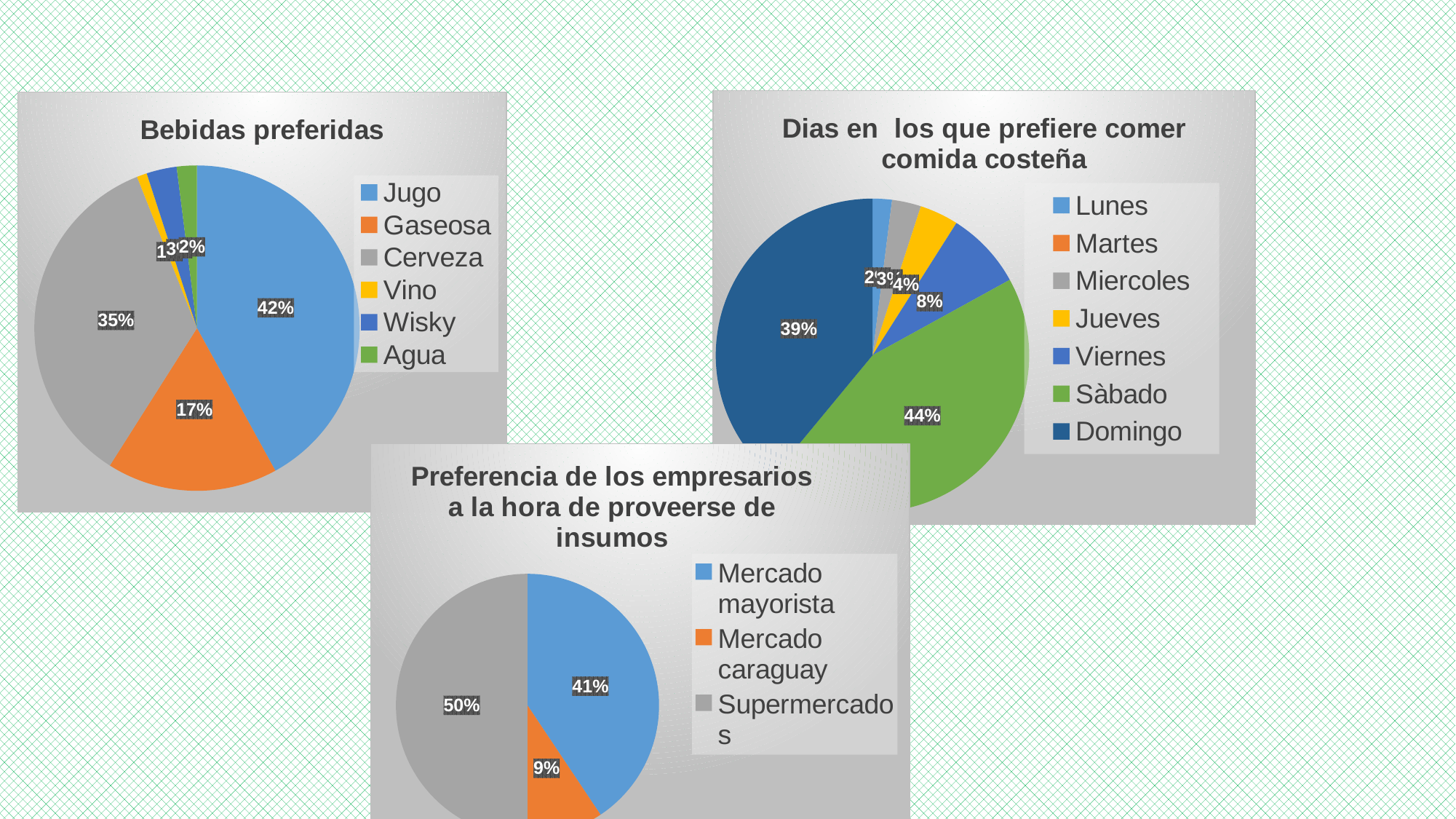
In the 'Bebidas preferidas' chart, which drink has the largest slice? Jugo How many entries does the legend of the 'Dias en los que prefiere comer comida costeña' chart list? 7 In the 'Dias en los que prefiere comer comida costeña' chart, what percentage is shown for Sàbado? 44% In the 'Bebidas preferidas' chart, what is the difference between the Jugo and Gaseosa percentages? 25% What type of chart is the 'Preferencia de los empresarios a la hora de proveerse de insumos' chart? Pie chart In the 'Dias en los que prefiere comer comida costeña' chart, what percentage is shown for Viernes? 8% In the 'Bebidas preferidas' chart, what percentage is shown for Cerveza? 35% In the 'Dias en los que prefiere comer comida costeña' chart, which is larger, Sàbado or Domingo? Sàbado How many categories does the legend of the 'Bebidas preferidas' chart list? 6 In the 'Preferencia de los empresarios a la hora de proveerse de insumos' chart, which category has the smallest slice? Mercado caraguay In the 'Preferencia de los empresarios a la hora de proveerse de insumos' chart, what percentage is shown for Supermercados? 50% In the 'Bebidas preferidas' chart, what percentage is shown for Jugo? 42%